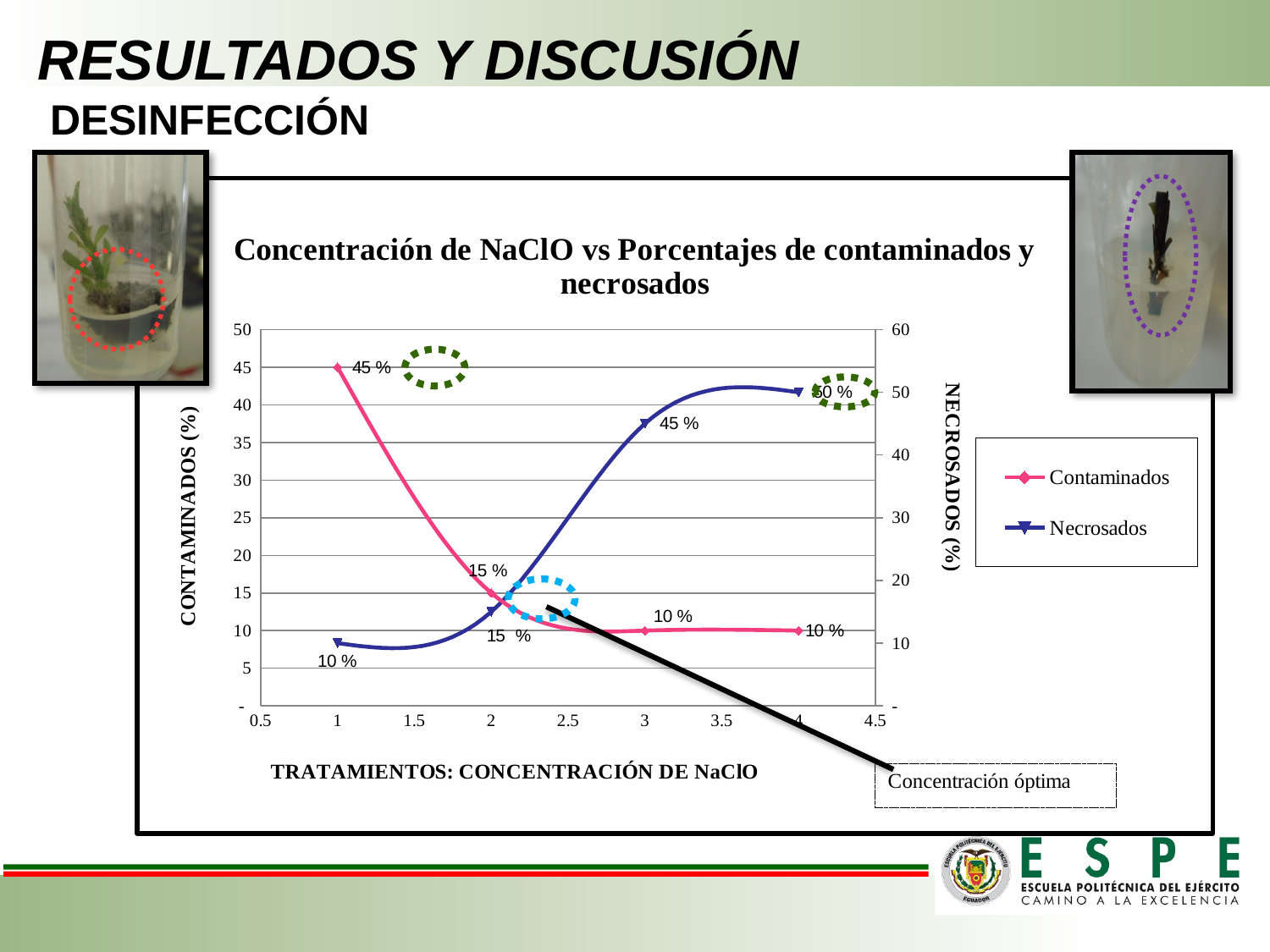
What is the Necrosados value at NaClO concentration 4? 50 % At which NaClO concentration is the Contaminados value highest? 1 What type of chart is shown on the slide? line chart What is the Contaminados value at NaClO concentration 2? 15 % What is the difference between the Contaminados value at concentration 1 and at concentration 2? 30 % At NaClO concentration 3, which series has the larger value, Contaminados or Necrosados? Necrosados Does the Necrosados series rise or fall as the NaClO concentration increases from 1 to 4? rise At which NaClO concentration is the Necrosados value lowest? 1 What is the Necrosados value at NaClO concentration 1? 10 % What is the title of the chart? Concentración de NaClO vs Porcentajes de contaminados y necrosados What is the Contaminados value at NaClO concentration 1? 45 % How many series does the legend list? 2